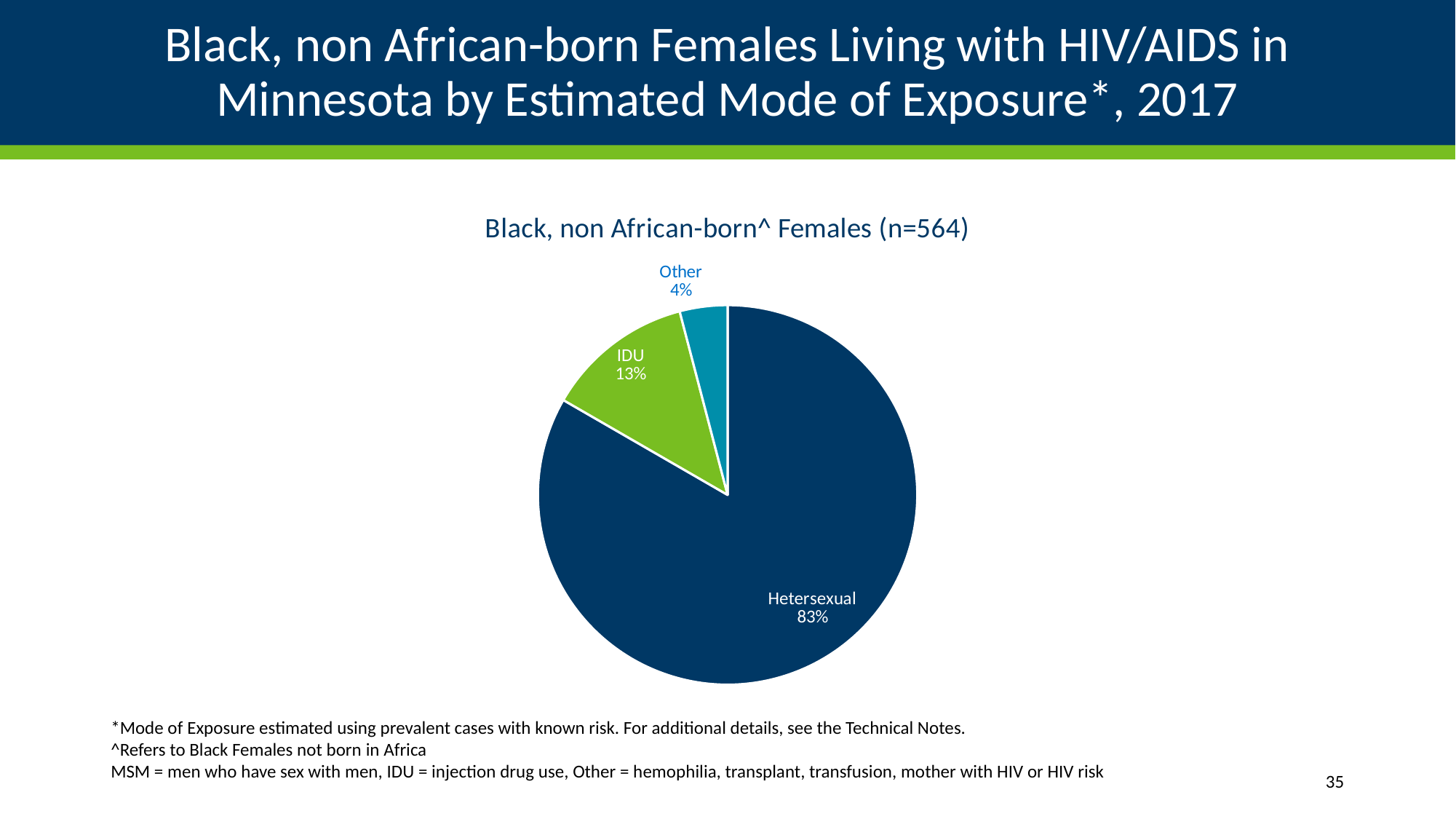
What kind of chart is shown on the slide? pie chart What percentage of the pie is Heterosexual? 83% What colour is the Heterosexual slice? dark blue Which mode of exposure has the smallest share of the pie? Other Which mode of exposure has the largest share of the pie? Heterosexual What is the difference in percentage points between the Heterosexual and IDU slices? 70 How many slices does the pie chart have? 3 What is the total number of cases (n) given in the chart title? 564 What percentage of the pie is IDU? 13% Which slice is larger, IDU or Other? IDU What percentage of the pie is Other? 4% What is the difference in percentage points between the IDU and Other slices? 9